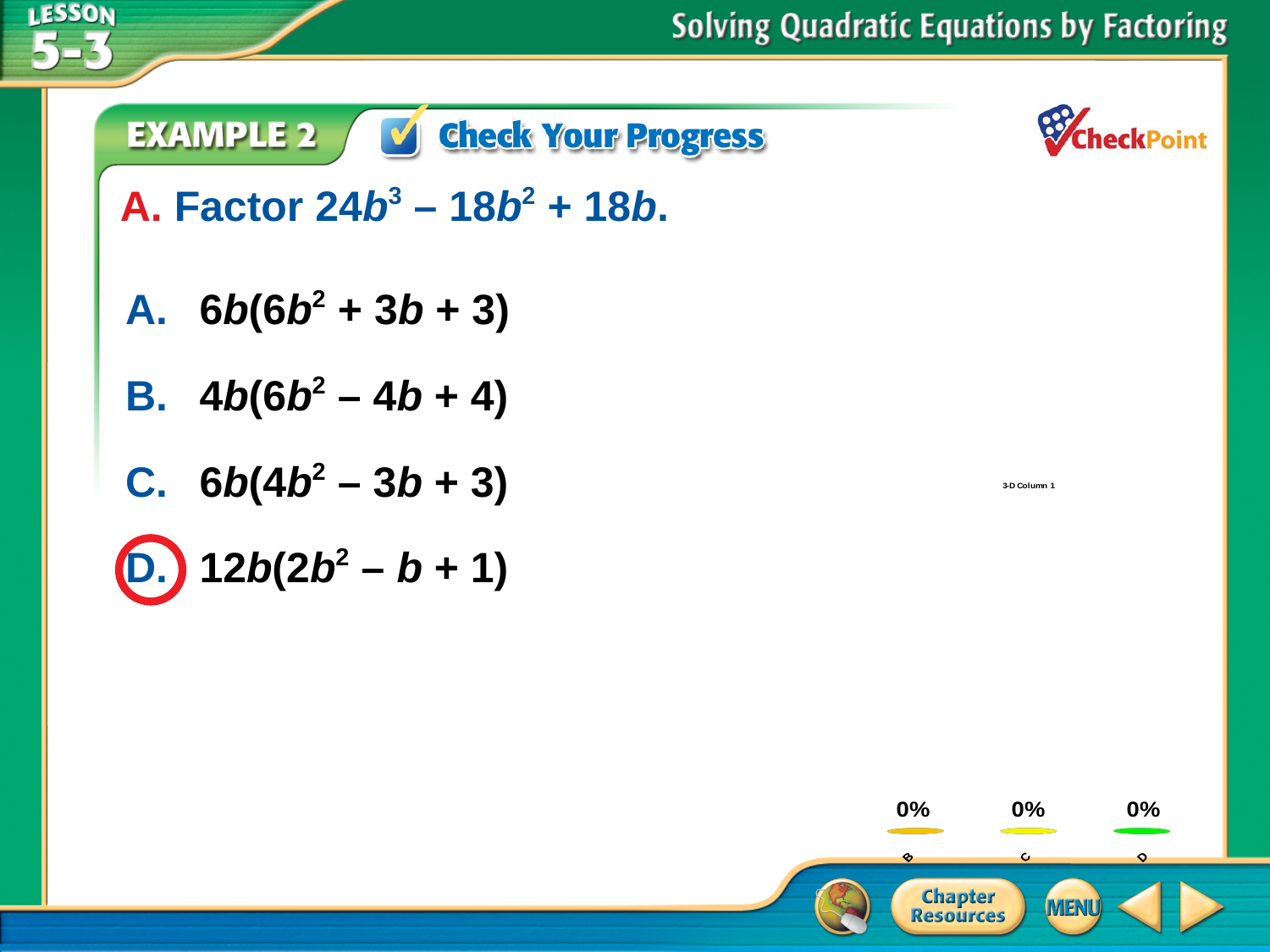
What kind of chart is shown at the bottom right of the slide? bar chart In the chart at the bottom right, do the values rise, fall, or stay the same from B to D? stay the same What is the value shown for category C in the chart at the bottom right? 0% What is the title of the chart at the bottom right of the slide? 3-D Column 1 In the chart at the bottom right, what colour is the bar for category D? green What is the value shown for category B in the chart at the bottom right? 0% What is the value shown for category D in the chart at the bottom right? 0%